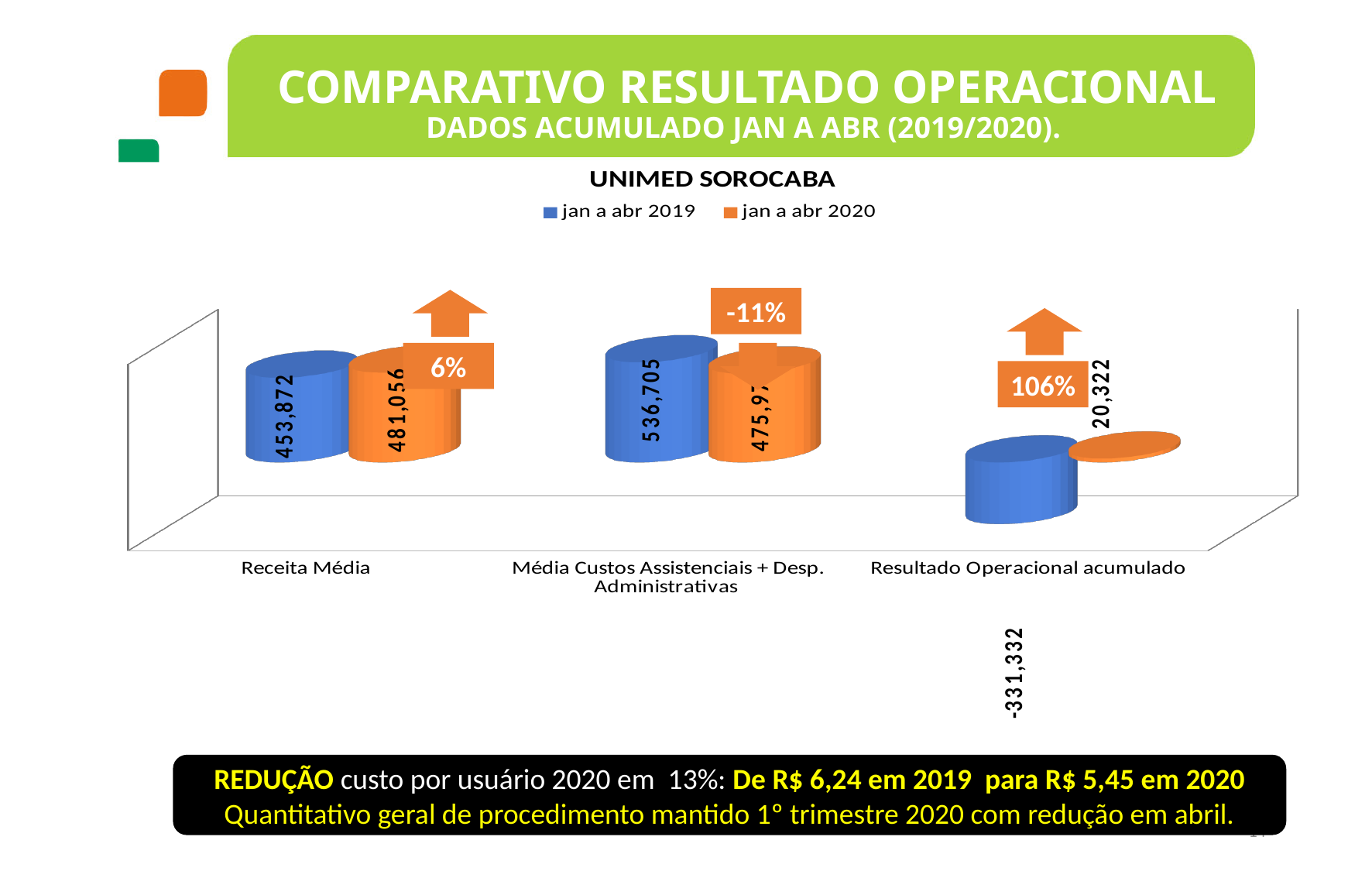
What is the difference between the jan a abr 2020 and jan a abr 2019 values for Receita Média? 27,184 How many series does the chart legend list? 2 What is the jan a abr 2019 value for Resultado Operacional acumulado? -331,332 Which category has the lowest value in the jan a abr 2019 series? Resultado Operacional acumulado Which series has the larger value for Receita Média, jan a abr 2019 or jan a abr 2020? jan a abr 2020 What is the value for Receita Média in the jan a abr 2020 series? 481,056 What is the jan a abr 2019 value for Média Custos Assistenciais + Desp. Administrativas? 536,705 What is the value for Receita Média in the jan a abr 2019 series? 453,872 How many categories are shown on the x axis of the chart? 3 What is the jan a abr 2020 value for Resultado Operacional acumulado? 20,322 Which series has the larger value for Média Custos Assistenciais + Desp. Administrativas, jan a abr 2019 or jan a abr 2020? jan a abr 2019 What percentage change label is shown above the Resultado Operacional acumulado bars? 106%